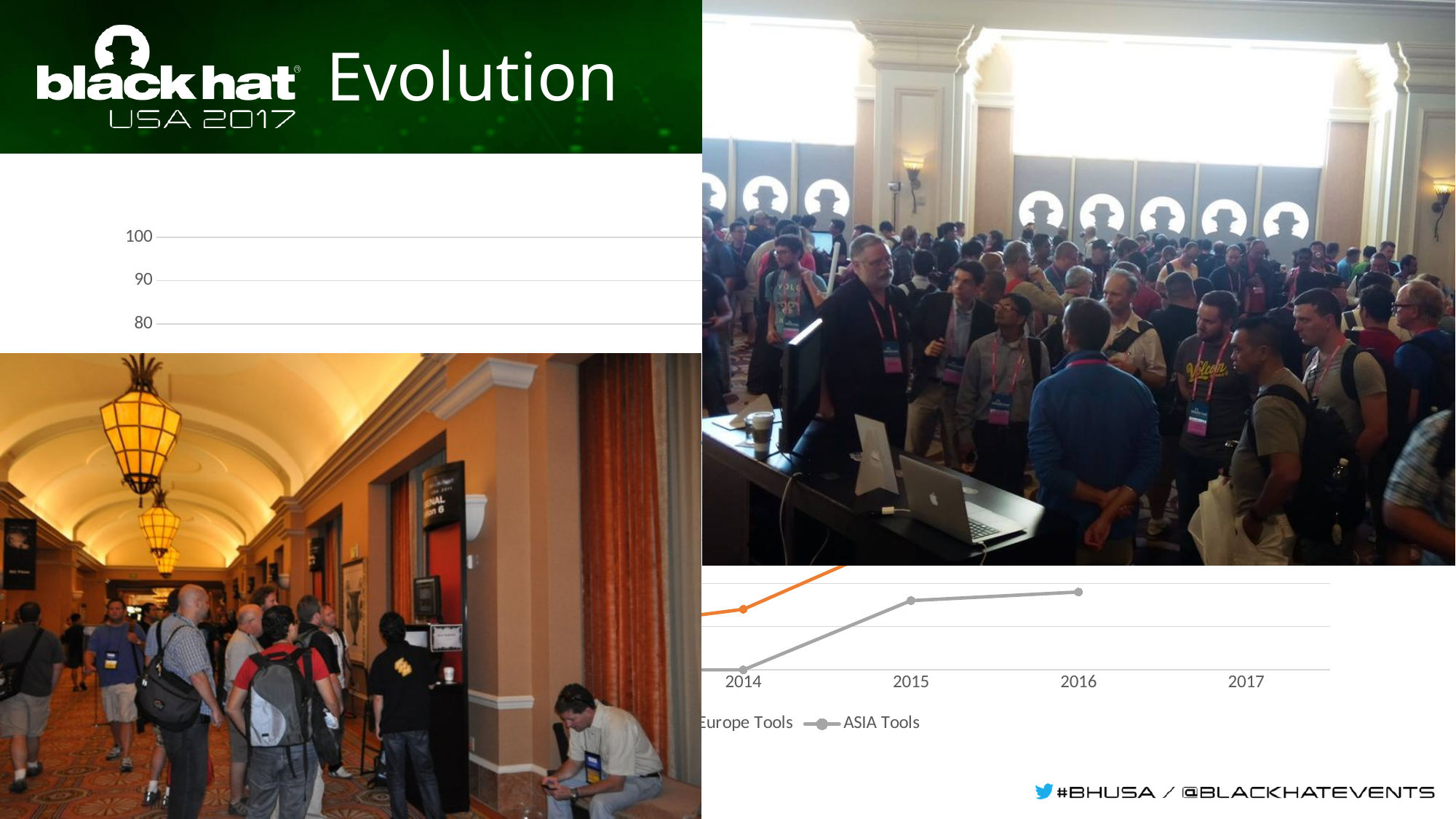
Which series is drawn in gray in the chart? ASIA Tools What is the highest value labelled on the chart's vertical axis? 100 Which is higher for ASIA Tools, the value in 2014 or the value in 2015? 2015 Does the ASIA Tools line rise or fall from 2014 to 2016? rise At 2014, which series has the higher value, Europe Tools or ASIA Tools? Europe Tools What kind of chart is shown on the slide? line chart Which is higher for ASIA Tools, the value in 2014 or the value in 2016? 2016